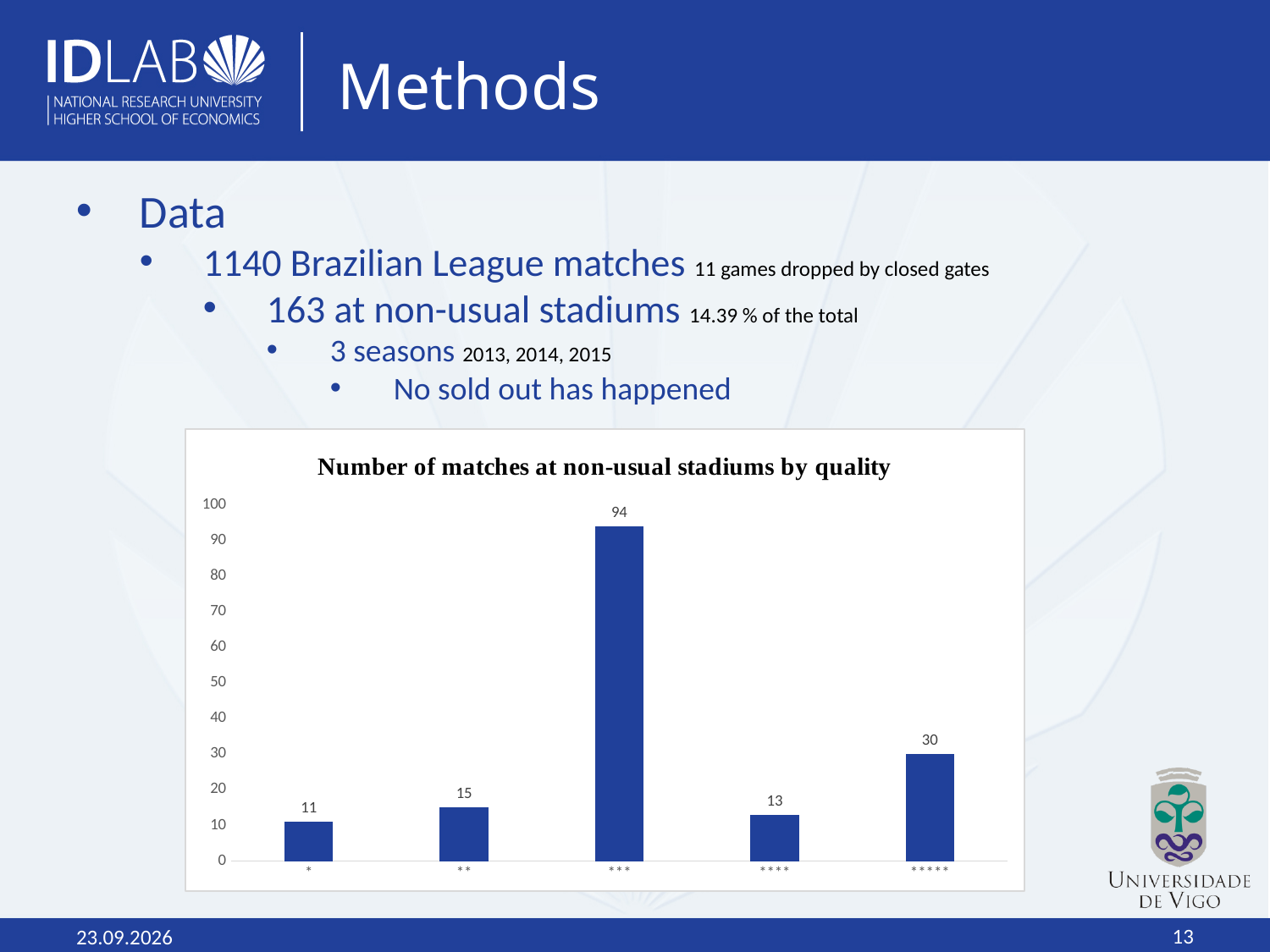
What is the number of matches at non-usual stadiums with *** quality? 94 What is the difference between the number of matches at *** stadiums and ***** stadiums? 64 What is the difference between the number of matches at ** stadiums and * stadiums? 4 What is the number of matches at non-usual stadiums with * quality? 11 Which quality category has the lowest number of matches? * What is the number of matches at non-usual stadiums with ***** quality? 30 What is the title of the chart? Number of matches at non-usual stadiums by quality How many quality categories are shown on the x axis? 5 Which has more matches, ** stadiums or **** stadiums? ** Is the value for ***** greater or less than 20? greater What kind of chart is shown on the slide? Bar chart Which quality category has the highest number of matches? ***